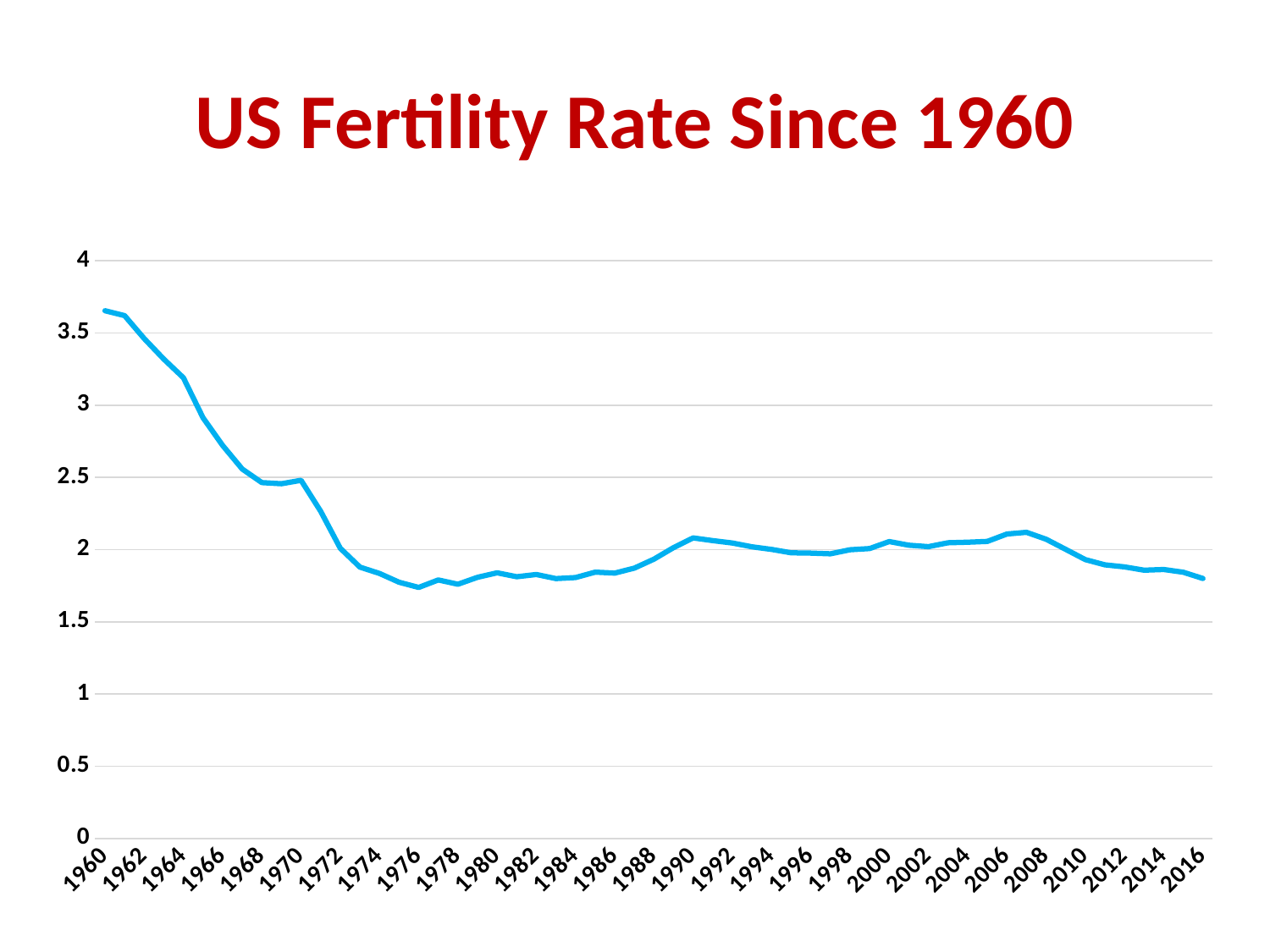
What is the title of the chart? US Fertility Rate Since 1960 How many year labels are shown on the x axis? 29 Is the value for 1990 greater or less than 2? greater Is the value for 1960 greater or less than 3.5? greater Is the value for 1974 greater or less than 2? less Does the fertility rate rise or fall between 1960 and 1976? fall What kind of chart is shown on the slide? line chart Which is larger, the value for 1960 or the value for 2016? 1960 Which year has the highest fertility rate on the chart? 1960